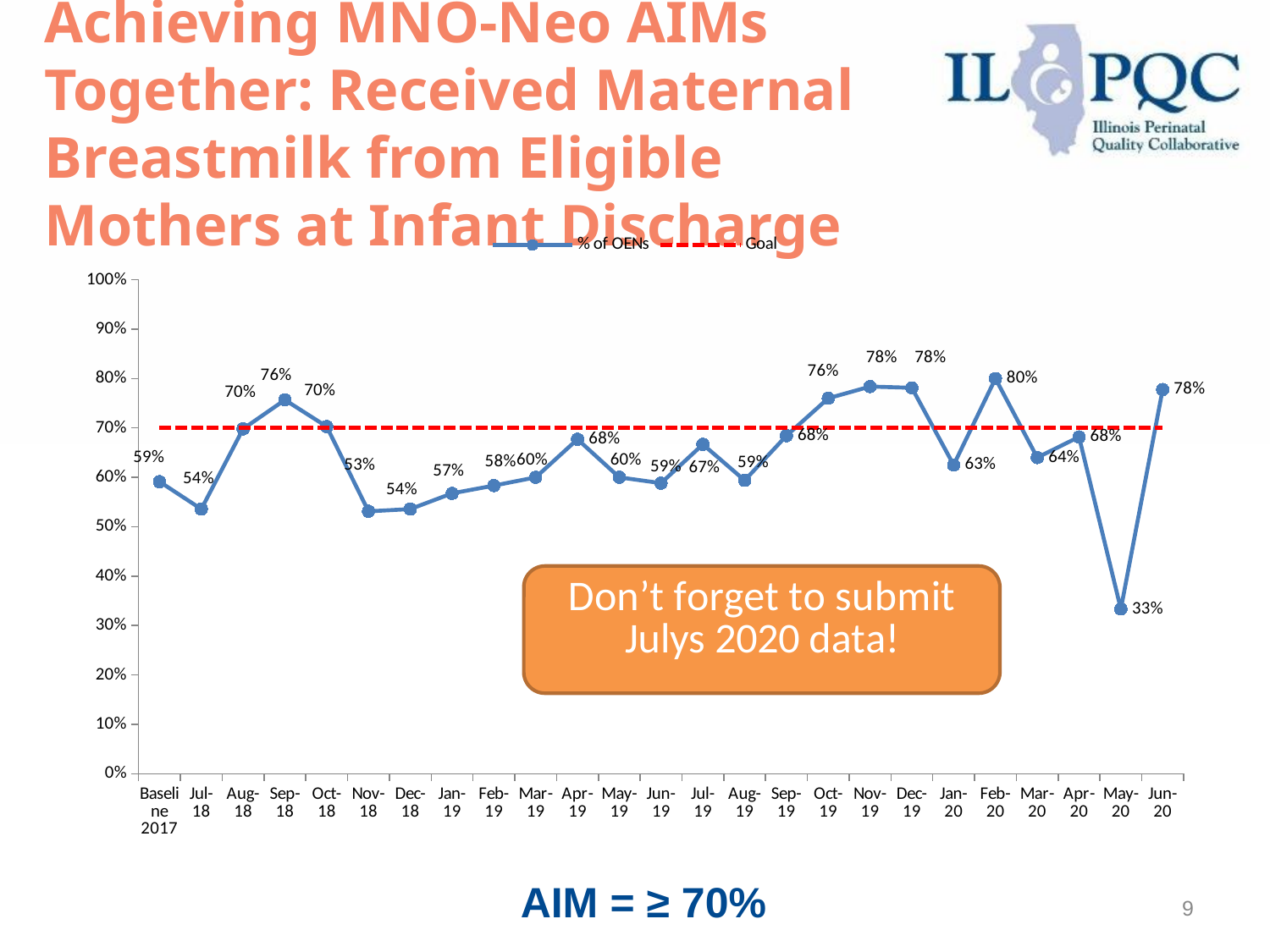
Which month has the lowest value? May-20 How many series does the legend list? 2 At what level is the dashed Goal line drawn? 70% Which is larger, the value for Nov-18 or the value for Jan-19? Jan-19 What is the value for Jun-20? 78% What is the value for Sep-18? 76% What is the difference between the values for Jun-20 and May-20? 45% What is the value for Baseline 2017? 59% What is the value for May-20? 33% Is the value for Oct-19 greater or less than 70%? greater What kind of chart is shown? line chart Which month has the highest value? Feb-20